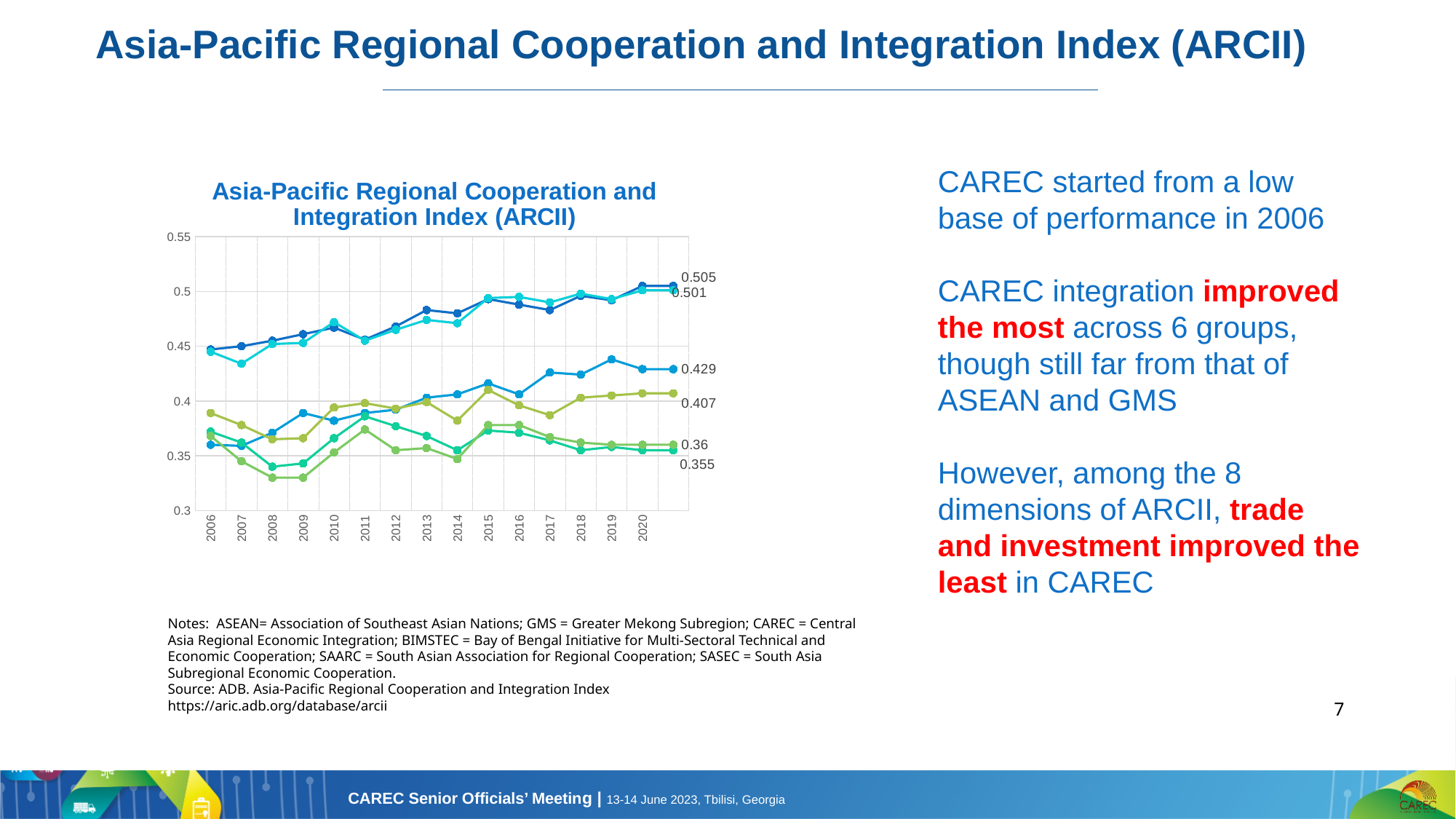
Does the topmost line generally rise or fall from 2006 to the end of the series? rise Is the value of the lowest line in 2008 greater or less than 0.35? less What is the title of the chart? Asia-Pacific Regional Cooperation and Integration Index (ARCII) What is the lowest end-of-series value labelled on the chart? 0.355 What is the difference between the highest (0.505) and lowest (0.355) end-of-series labels? 0.15 How many lines (series) are plotted in the chart? 6 What kind of chart is shown on the slide? line chart What is the difference between the end-of-series labels 0.429 and 0.407? 0.022 Is the value of the topmost line in 2006 greater or less than 0.4? greater What is the difference between the two highest end-of-series labels, 0.505 and 0.501? 0.004 What is the highest end-of-series value labelled on the chart? 0.505 Which end-of-series value is larger, 0.429 or 0.407? 0.429